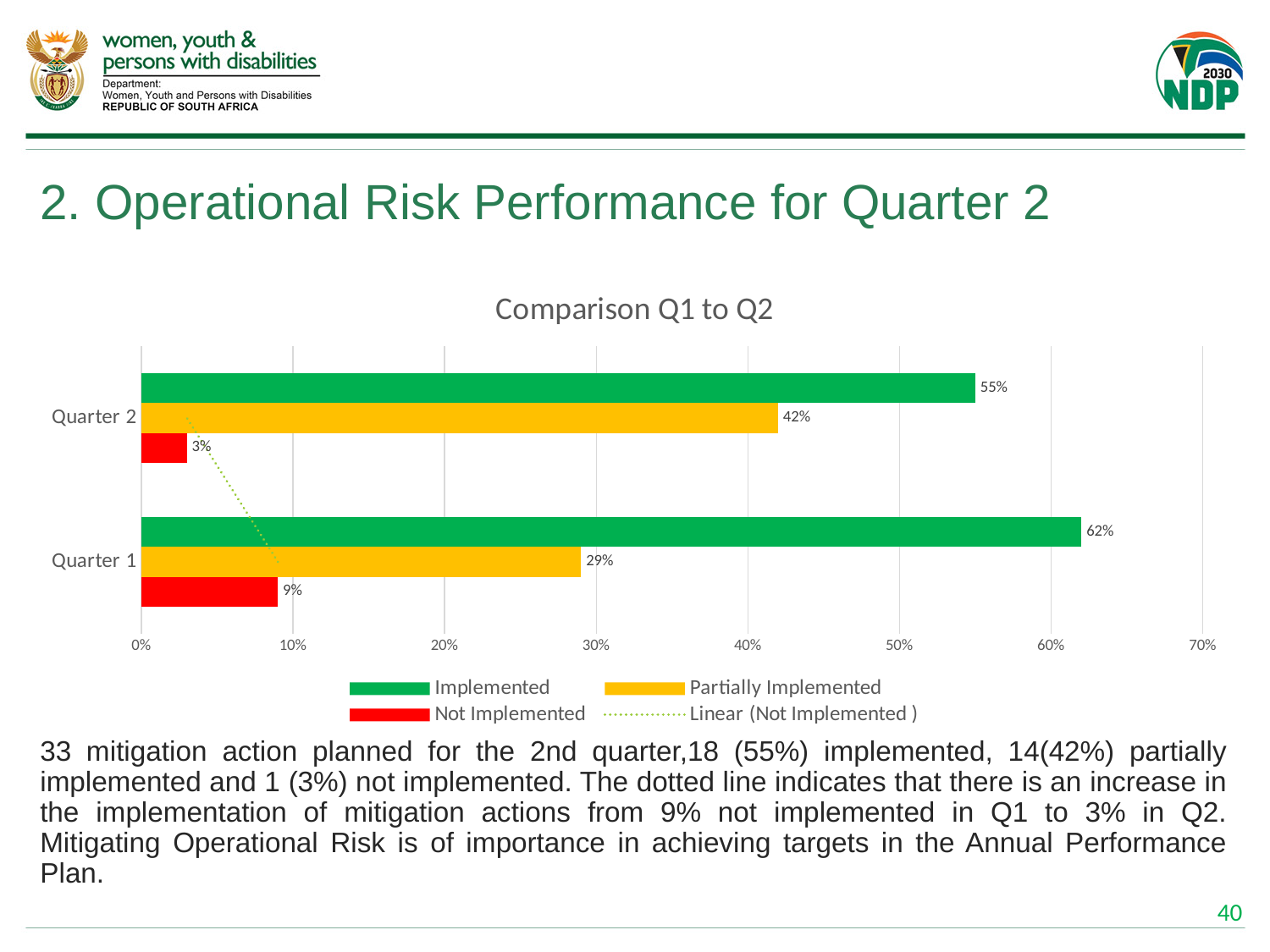
What is the Partially Implemented value for Quarter 1? 29% What is the difference between the Partially Implemented values for Quarter 2 and Quarter 1? 13% What is the Not Implemented value for Quarter 2? 3% Which quarter has the lower Not Implemented value? Quarter 2 How many quarters are shown on the chart? 2 What is the Implemented value for Quarter 1? 62% Is the Partially Implemented value for Quarter 2 larger than the Partially Implemented value for Quarter 1? Yes Which quarter has the higher Implemented value? Quarter 1 What is the Implemented value for Quarter 2? 55% What is the difference between the Not Implemented values for Quarter 1 and Quarter 2? 6% What is the title of the chart? Comparison Q1 to Q2 What type of chart is shown on the slide? Bar chart